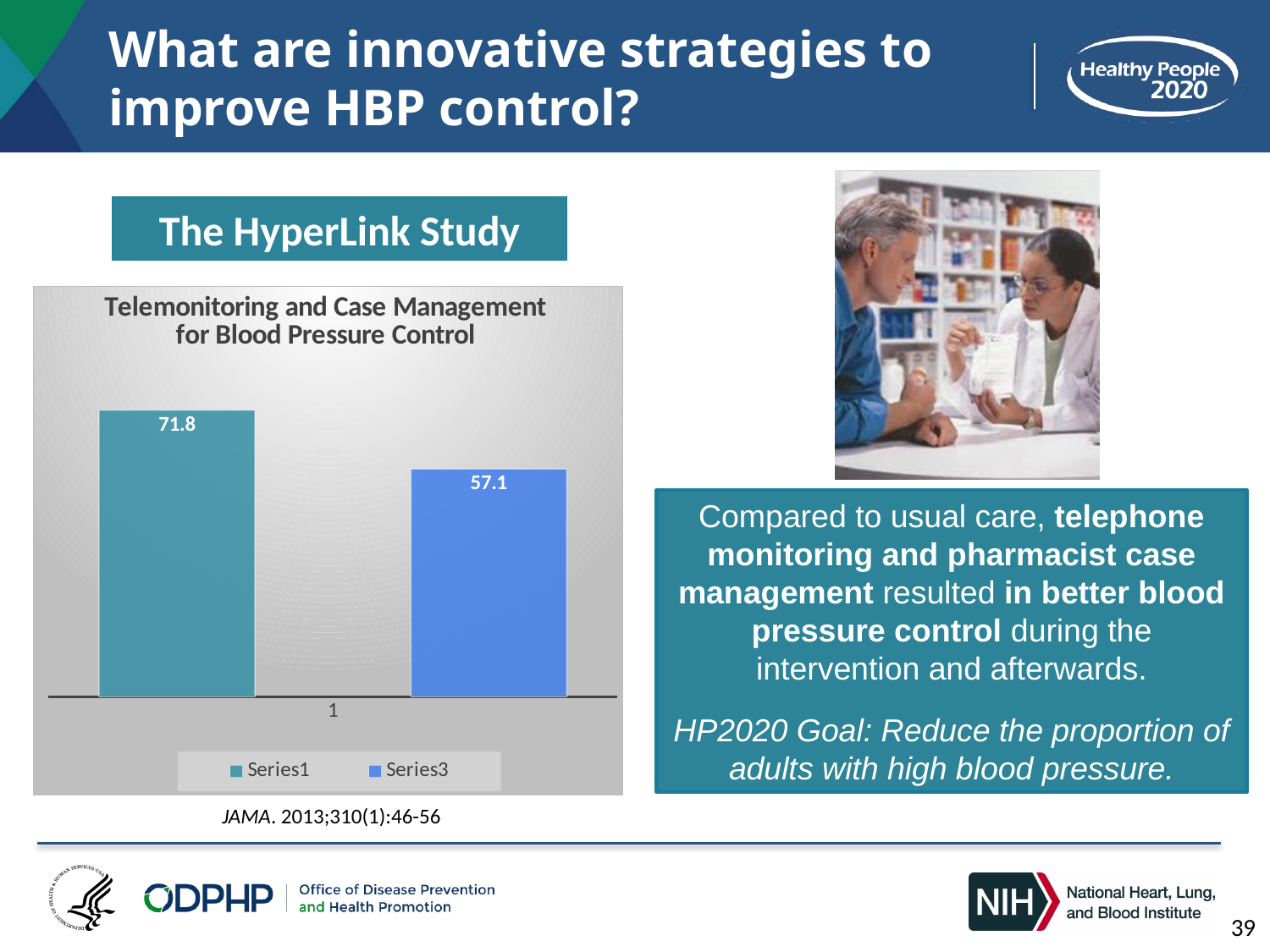
How many bars are plotted in the chart? 2 What is the value for Series1 in the chart? 71.8 What kind of chart is shown on the slide? Bar chart How many series does the chart legend list? 2 What is the category label shown on the x axis of the chart? 1 What is the difference between the Series1 value and the Series3 value? 14.7 What is the title of the chart? Telemonitoring and Case Management for Blood Pressure Control Which series has the higher value, Series1 or Series3? Series1 Which series has the lowest value in the chart? Series3 What is the value for Series3 in the chart? 57.1